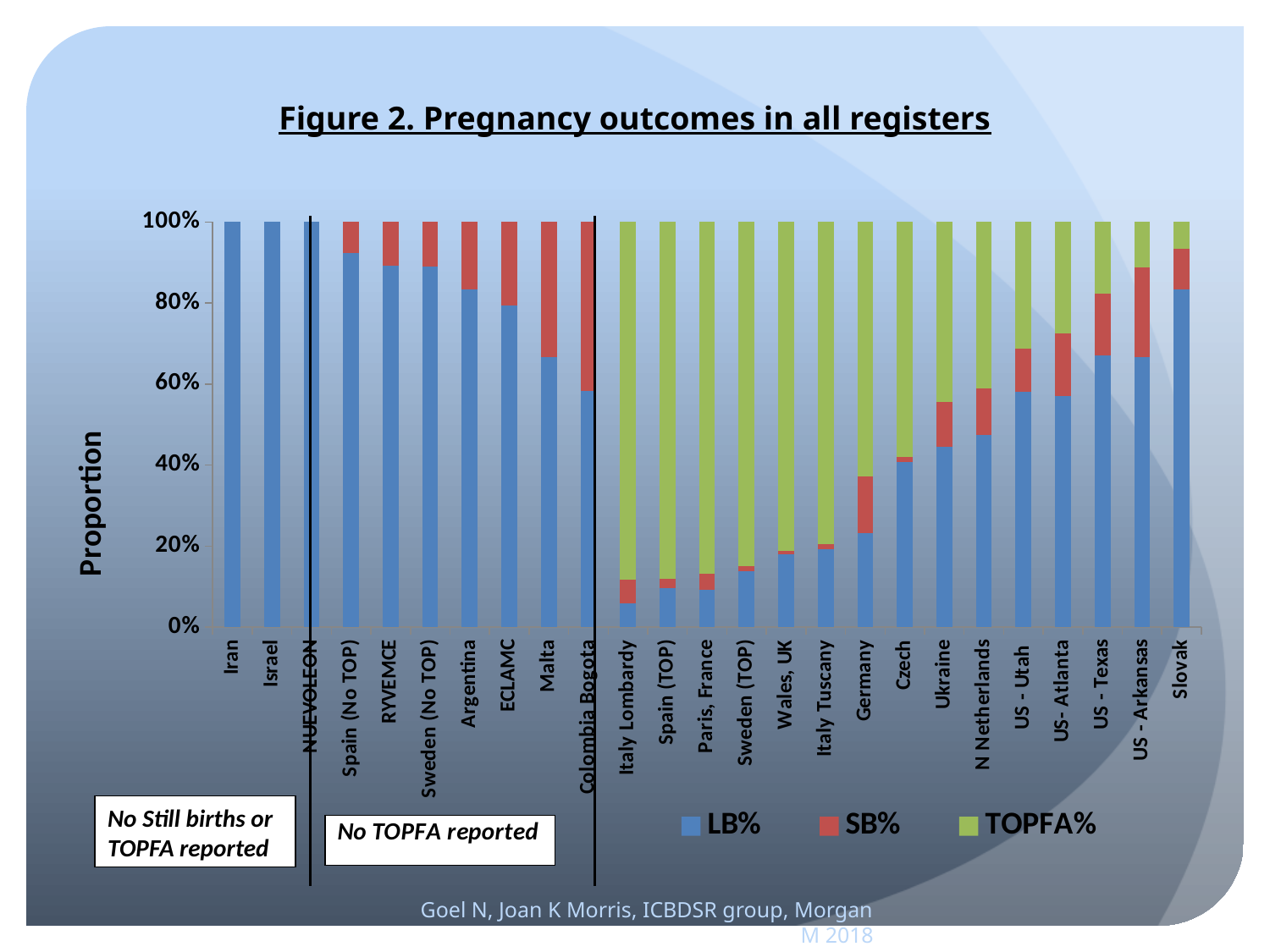
What is the total of the stacked bar for Slovak? 100% Which register has the lowest LB% value? Italy Lombardy What kind of chart is shown on the slide? Stacked bar chart Is the LB% value for Colombia Bogota greater or less than 60%? less What is the LB% value for Iran? 100% Which has the larger LB% value, Malta or Colombia Bogota? Malta Is the LB% value for Slovak greater or less than 80%? greater How many registers (categories) are plotted along the x axis? 25 What is the title of the chart? Figure 2. Pregnancy outcomes in all registers Among the registers from Italy Lombardy to Slovak, does the LB% value generally rise or fall from left to right? rise How many series does the legend list? 3